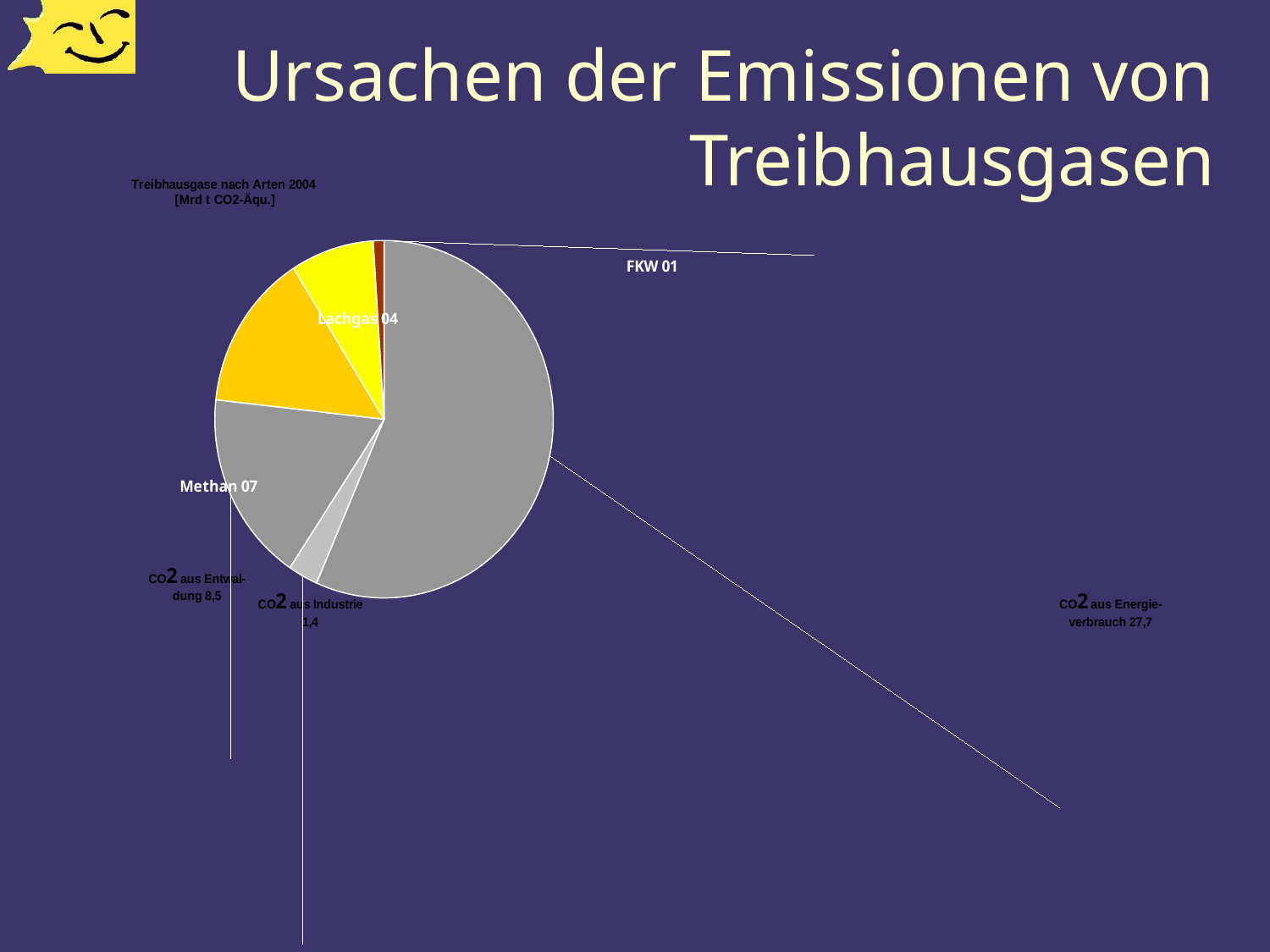
What is the value for CO2 aus Industrie? 1,4 What kind of chart is shown on the slide? pie chart What is the difference between CO2 aus Energieverbrauch and CO2 aus Entwaldung? 19,2 How many slices does the pie chart have? 6 What is the title of the pie chart? Treibhausgase nach Arten 2004 [Mrd t CO2-Äqu.] Which category has the largest slice of the pie? CO2 aus Energieverbrauch Which is larger, CO2 aus Entwaldung or CO2 aus Industrie? CO2 aus Entwaldung What is the difference between CO2 aus Entwaldung and CO2 aus Industrie? 7,1 What value is printed next to the Methan label? 07 What is the value for CO2 aus Entwaldung? 8,5 What is the value for CO2 aus Energieverbrauch? 27,7